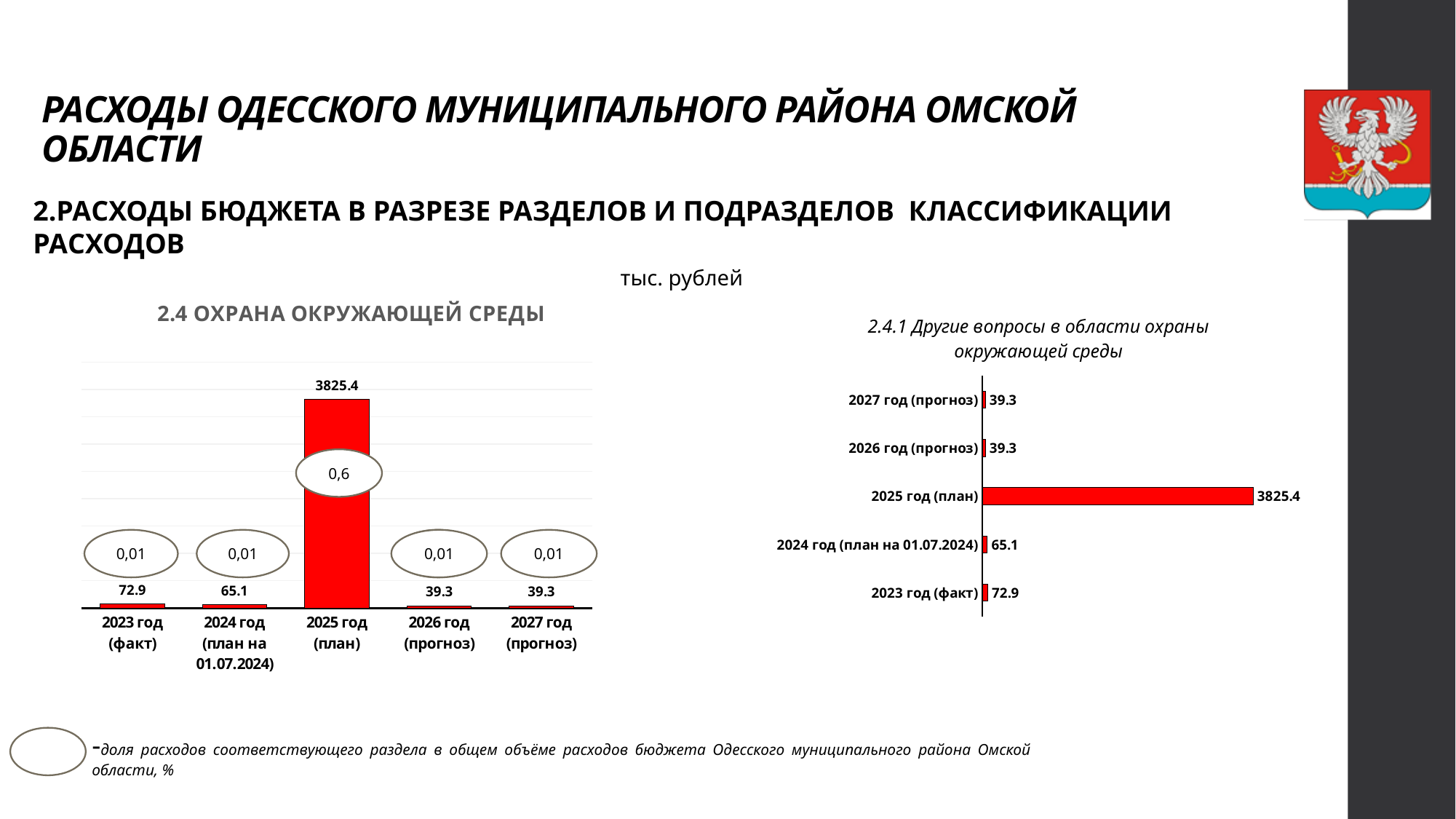
In the chart '2.4 ОХРАНА ОКРУЖАЮЩЕЙ СРЕДЫ', what share (in the oval) is shown for 2025 год (план)? 0,6 In the chart '2.4 ОХРАНА ОКРУЖАЮЩЕЙ СРЕДЫ', which category has the highest value? 2025 год (план) In the chart '2.4 ОХРАНА ОКРУЖАЮЩЕЙ СРЕДЫ', what is the value for 2025 год (план)? 3825.4 What unit of measurement is stated above the charts on the slide? тыс. рублей In the chart '2.4.1 Другие вопросы в области охраны окружающей среды', what is the difference between the values for 2025 год (план) and 2026 год (прогноз)? 3786.1 In the chart '2.4 ОХРАНА ОКРУЖАЮЩЕЙ СРЕДЫ', how many categories are shown on the x axis? 5 In the chart '2.4.1 Другие вопросы в области охраны окружающей среды', which is larger: the value for 2023 год (факт) or 2026 год (прогноз)? 2023 год (факт) In the chart '2.4 ОХРАНА ОКРУЖАЮЩЕЙ СРЕДЫ', what is the value for 2023 год (факт)? 72.9 What type of chart is '2.4.1 Другие вопросы в области охраны окружающей среды'? Bar chart In the chart '2.4 ОХРАНА ОКРУЖАЮЩЕЙ СРЕДЫ', what is the difference between the values for 2023 год (факт) and 2024 год (план на 01.07.2024)? 7.8 In the chart '2.4.1 Другие вопросы в области охраны окружающей среды', what is the value for 2024 год (план на 01.07.2024)? 65.1 In the chart '2.4.1 Другие вопросы в области охраны окружающей среды', what is the value for 2027 год (прогноз)? 39.3